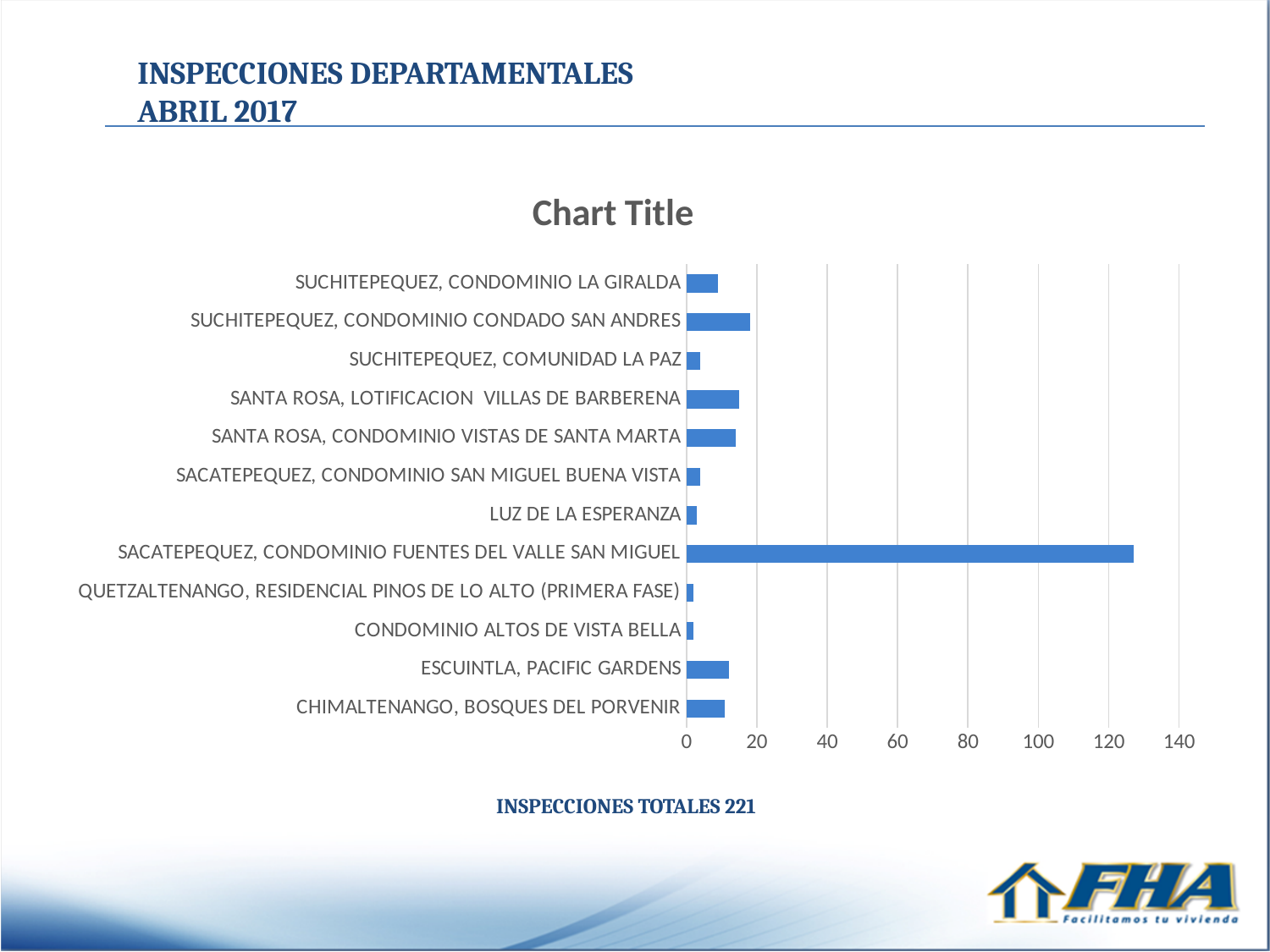
Which category has the highest value in the chart? SACATEPEQUEZ, CONDOMINIO FUENTES DEL VALLE SAN MIGUEL What is the highest value shown on the horizontal axis of the chart? 140 What kind of chart is shown on the slide? bar chart How many categories are plotted in the chart? 12 Is the value for SACATEPEQUEZ, CONDOMINIO FUENTES DEL VALLE SAN MIGUEL greater or less than 140? less Is the value for SACATEPEQUEZ, CONDOMINIO FUENTES DEL VALLE SAN MIGUEL greater or less than 120? greater Is the value for ESCUINTLA, PACIFIC GARDENS greater or less than 20? less Which has a larger value: SUCHITEPEQUEZ, CONDOMINIO CONDADO SAN ANDRES or SUCHITEPEQUEZ, COMUNIDAD LA PAZ? SUCHITEPEQUEZ, CONDOMINIO CONDADO SAN ANDRES Which has a larger value: CHIMALTENANGO, BOSQUES DEL PORVENIR or CONDOMINIO ALTOS DE VISTA BELLA? CHIMALTENANGO, BOSQUES DEL PORVENIR Which has a larger value: SANTA ROSA, LOTIFICACION VILLAS DE BARBERENA or LUZ DE LA ESPERANZA? SANTA ROSA, LOTIFICACION VILLAS DE BARBERENA What is the title shown above the chart? Chart Title